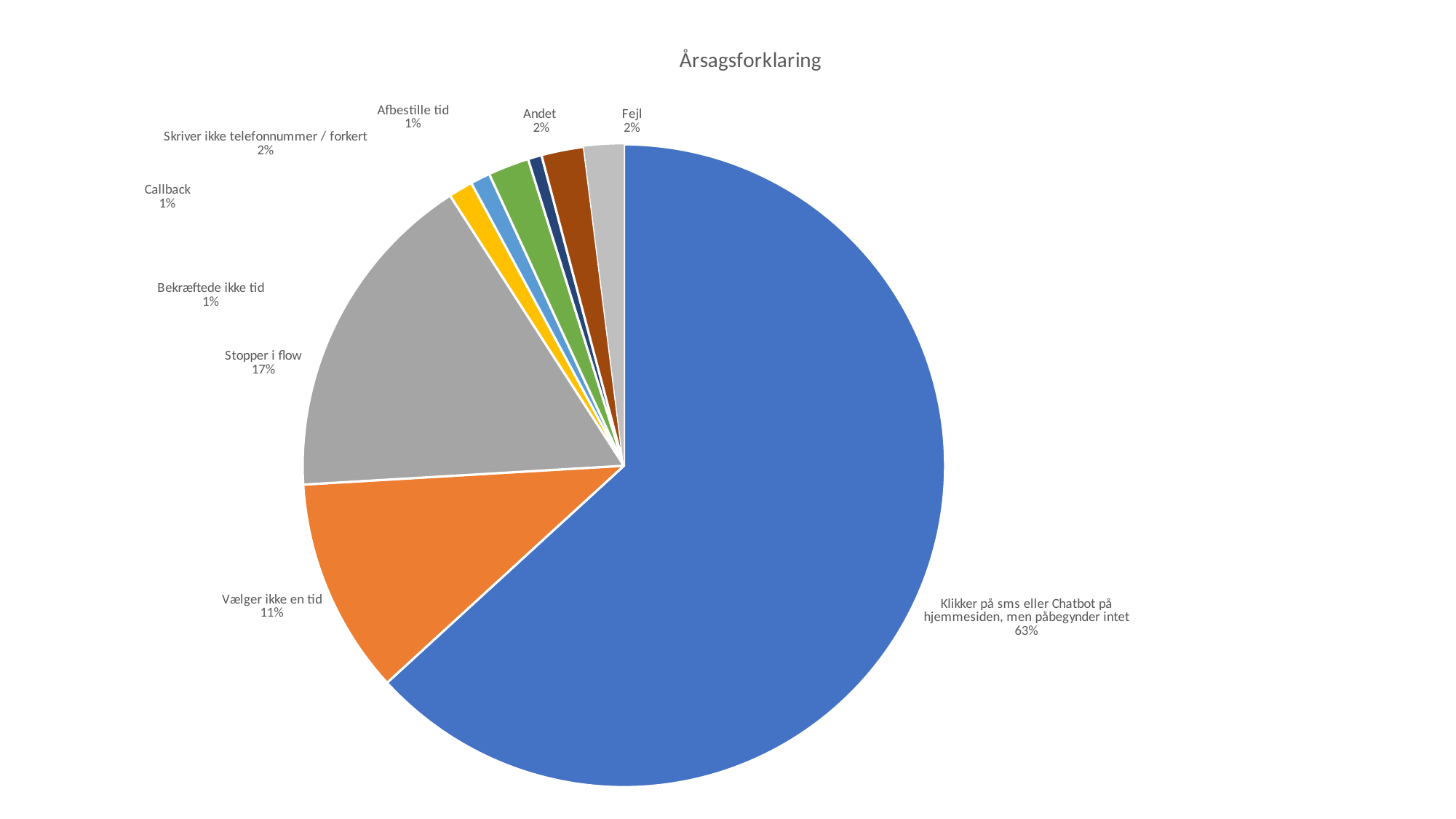
What percentage is shown for "Callback"? 1% What is the title of the chart? Årsagsforklaring What colour is the largest slice of the pie? Blue What percentage is shown for "Skriver ikke telefonnummer / forkert"? 2% Which category has the largest slice of the pie? Klikker på sms eller Chatbot på hjemmesiden, men påbegynder intet What is the difference in percentage points between "Stopper i flow" and "Vælger ikke en tid"? 6 What type of chart is shown on the slide? Pie chart How many slices does the pie chart have? 9 What share of the pie does "Stopper i flow" represent? 17% What percentage is shown for "Klikker på sms eller Chatbot på hjemmesiden, men påbegynder intet"? 63% Which is larger, "Stopper i flow" or "Vælger ikke en tid"? Stopper i flow What share of the pie does "Vælger ikke en tid" represent? 11%